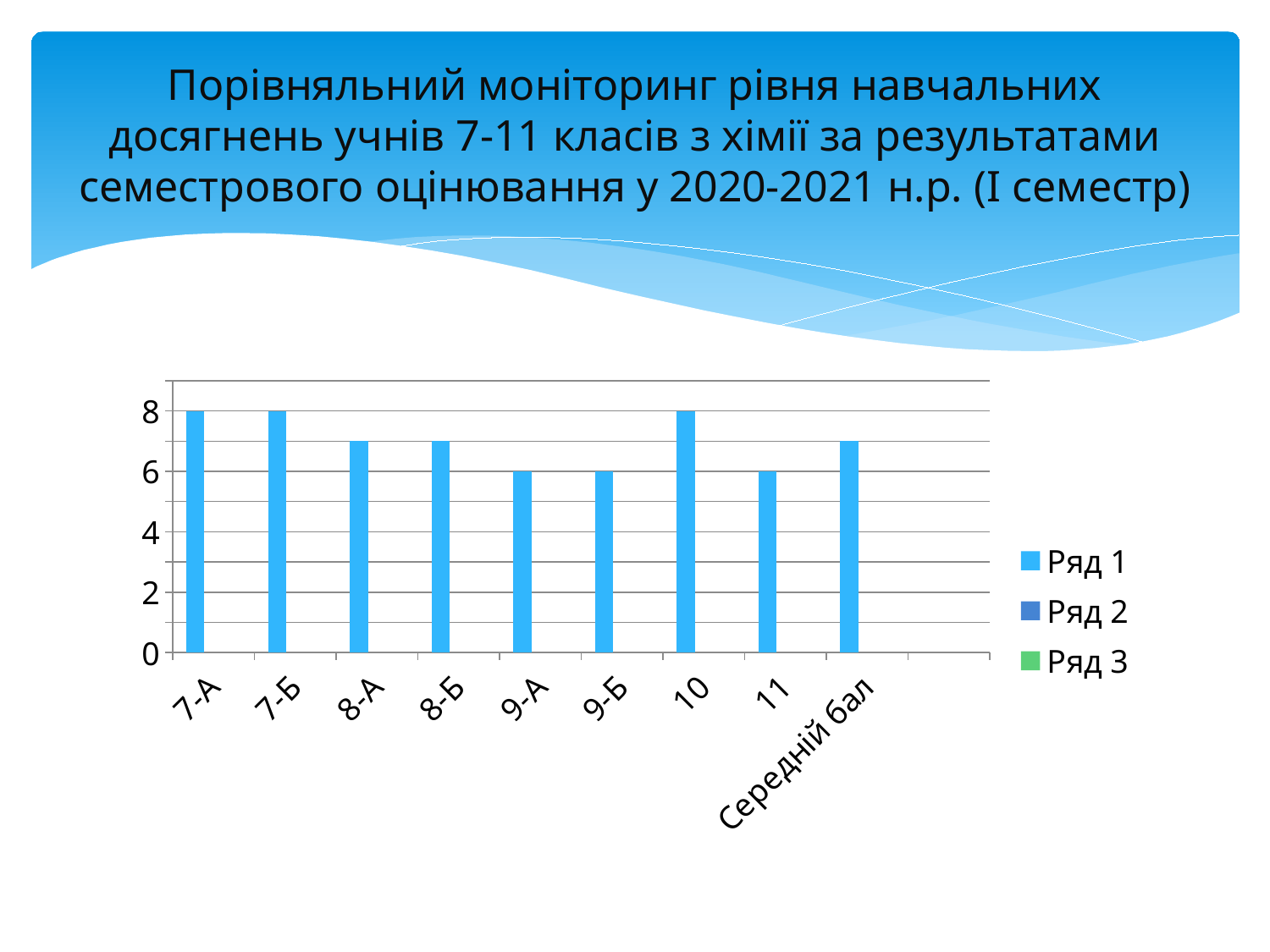
What is the value for 11? 6 Which is larger, the value for 7-Б or the value for 8-Б? 7-Б Which is larger, the value for 10 or the value for 11? 10 Is the value for Середній бал greater or less than 8? less What is the difference between the value for 7-А and the value for 9-А? 2 Is the value for 8-А greater or less than 6? greater What is the value for 7-А? 8 What is the value for 9-Б? 6 How many categories are shown on the x axis? 9 What kind of chart is shown on the slide? bar chart What is the value for 10? 8 How many series does the legend list? 3